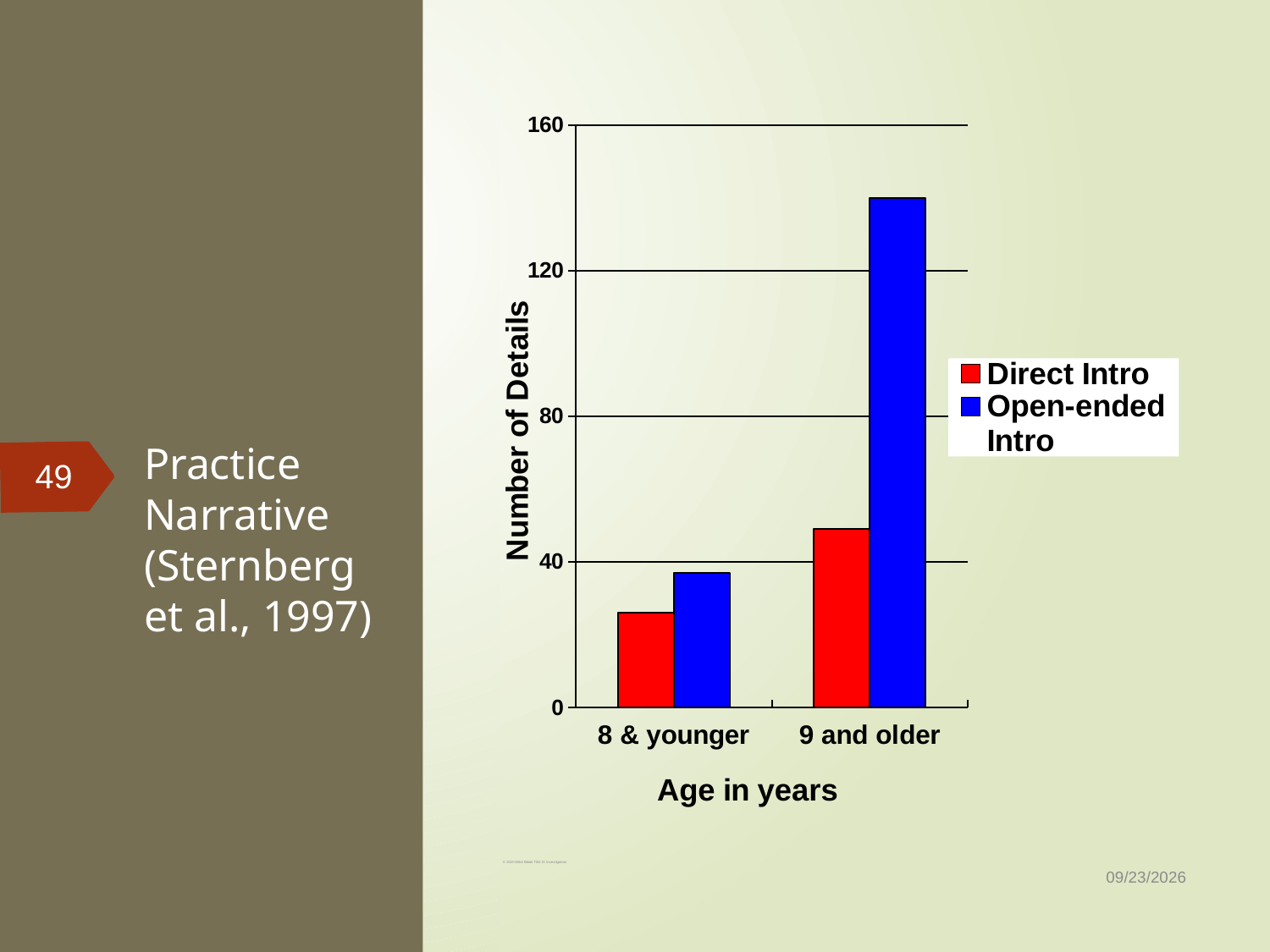
How many series does the legend list? 2 Do the Open-ended Intro values rise or fall from 8 & younger to 9 and older? rise How many age categories are shown on the x axis? 2 Which age group and series has the tallest bar? Open-ended Intro, 9 and older For the 8 & younger group, which is larger: Direct Intro or Open-ended Intro? Open-ended Intro Which age group and series has the shortest bar? Direct Intro, 8 & younger Is the Open-ended Intro value for 9 and older greater or less than 120? greater Is the Direct Intro value for 9 and older greater or less than 40? greater What kind of chart is shown on the slide? bar chart For the 9 and older group, which is larger: Direct Intro or Open-ended Intro? Open-ended Intro Is the Direct Intro value for 8 & younger greater or less than 40? less What is the label on the vertical axis of the chart? Number of Details